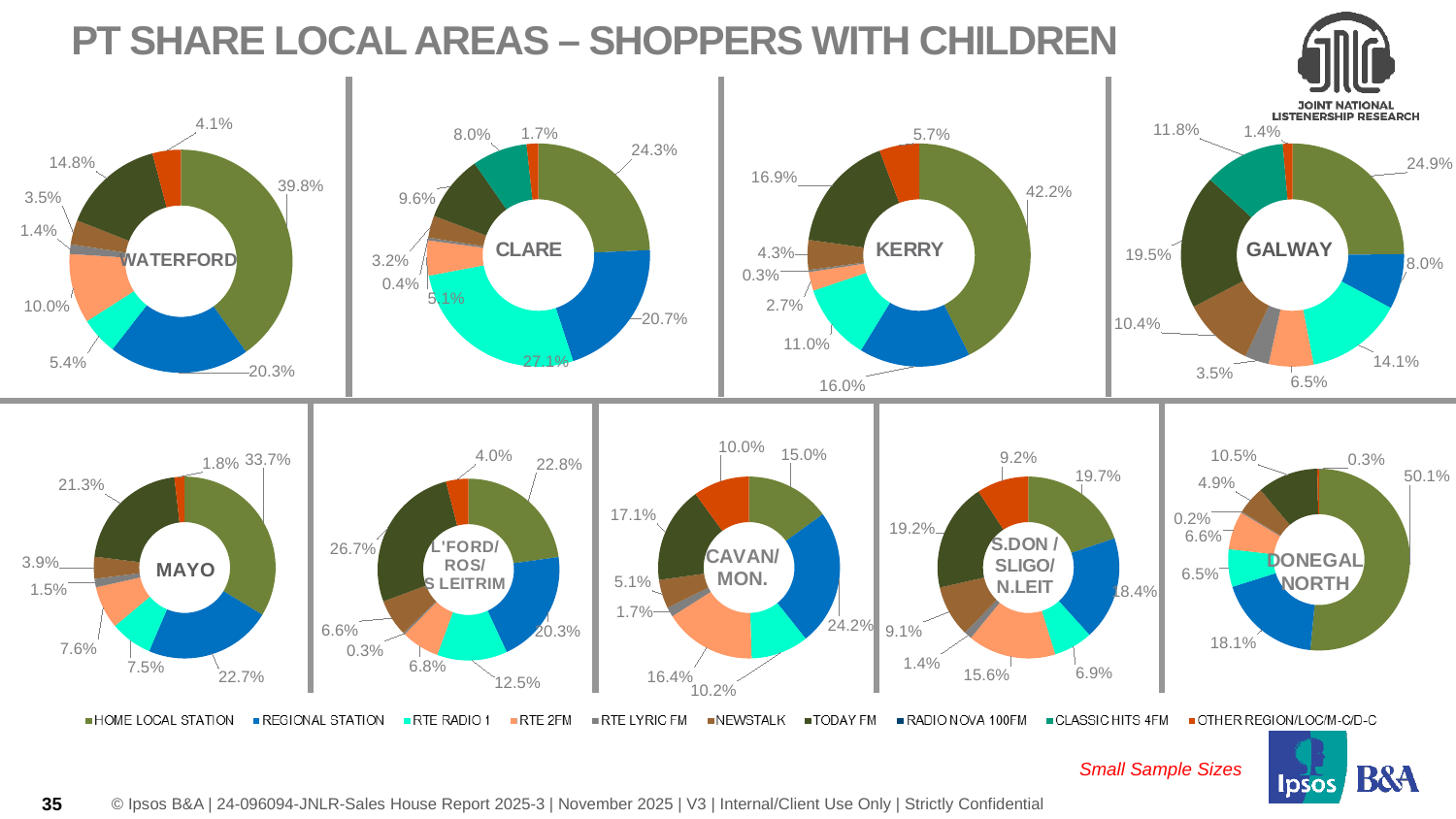
In the KERRY chart, what is the share for the largest slice? 42.2% In the CLARE chart, what is the largest share shown? 27.1% How many donut charts are shown on the slide? 9 What kind of chart is used for each local area on the slide? Donut (pie) chart In the DONEGAL NORTH chart, what share does the HOME LOCAL STATION (largest slice) have? 50.1% How many stations does the legend at the bottom of the slide list? 10 What is the title of the slide? PT SHARE LOCAL AREAS – SHOPPERS WITH CHILDREN In the S.DON / SLIGO/ N.LEIT chart, what is the smallest share shown? 1.4% In the GALWAY chart, what is the smallest share shown? 1.4% In the MAYO chart, what is the difference between the largest share (33.7%) and the REGIONAL STATION share (22.7%)? 11.0% In the CAVAN/MON. chart, which is larger: the REGIONAL STATION share (24.2%) or the HOME LOCAL STATION share (15.0%)? REGIONAL STATION In the WATERFORD chart, what is the largest share shown? 39.8%